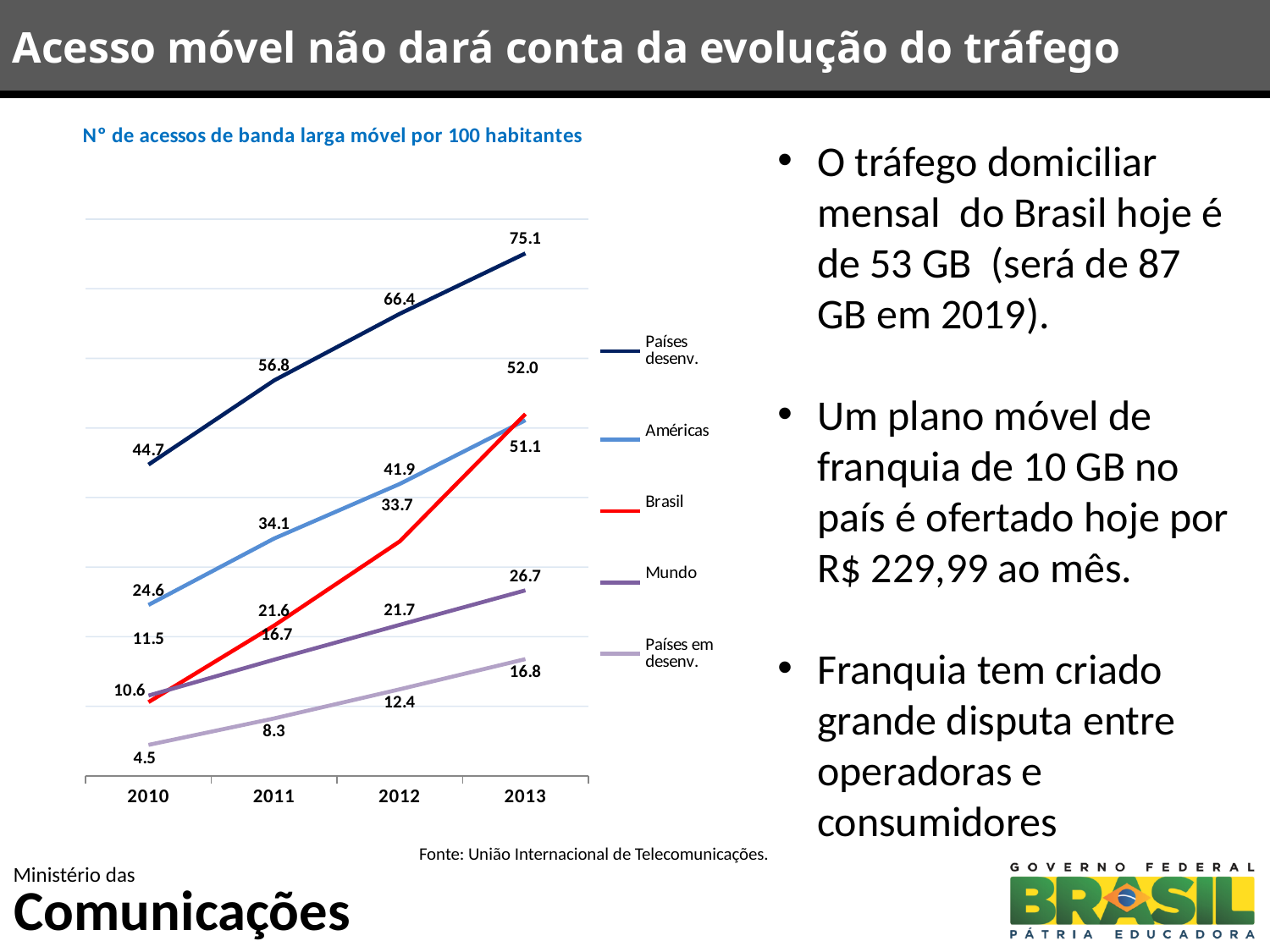
What is the value for Brasil in 2012? 33.7 What is the value for Mundo in 2013? 26.7 Does the value for Países em desenv. rise or fall from 2010 to 2013? rise Which series has the highest value in 2013? Países desenv. Which series has the lowest value in 2010? Países em desenv. What is the value for Países em desenv. in 2010? 4.5 How many series does the chart legend list? 5 In 2012, which is larger: the value for Américas or the value for Brasil? Américas By how much did the value for Países desenv. increase from 2010 to 2013? 30.4 How many years are shown on the x axis of the chart? 4 What kind of chart is shown on the slide? line chart What is the value for Países desenv. in 2013? 75.1